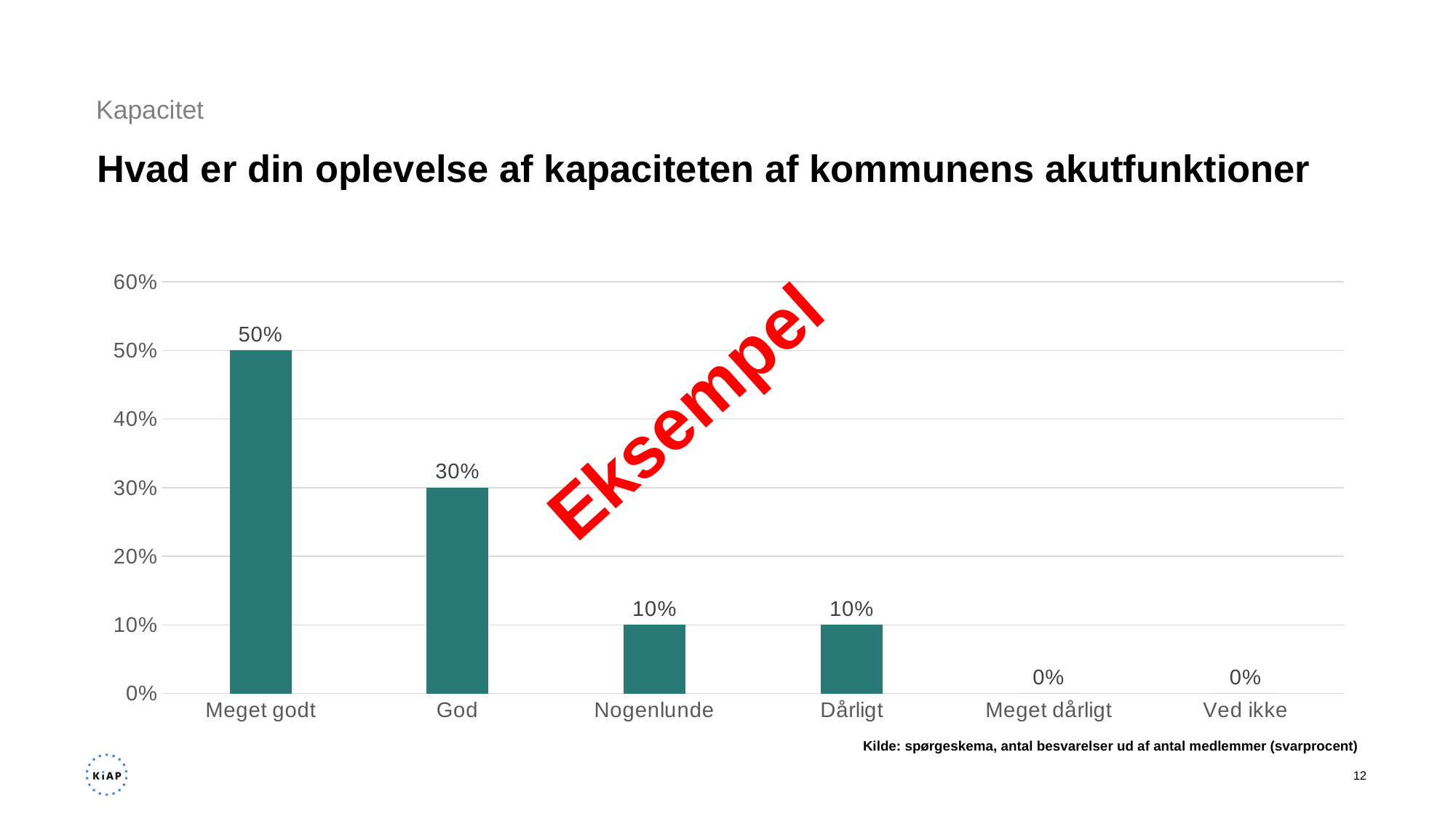
How many categories are shown on the x axis? 6 Which is larger, the value for God or the value for Dårligt? God Which category has the highest value? Meget godt What is the difference between the values for Meget godt and God? 20% Do the values rise or fall from Meget godt to Ved ikke along the x axis? fall What is the value for Meget godt? 50% What kind of chart is shown on the slide? bar chart What is the value for God? 30% What is the highest value shown on the y axis? 60% Is the value for Meget godt greater or less than 40%? greater What is the value for Nogenlunde? 10% What is the value for Meget dårligt? 0%